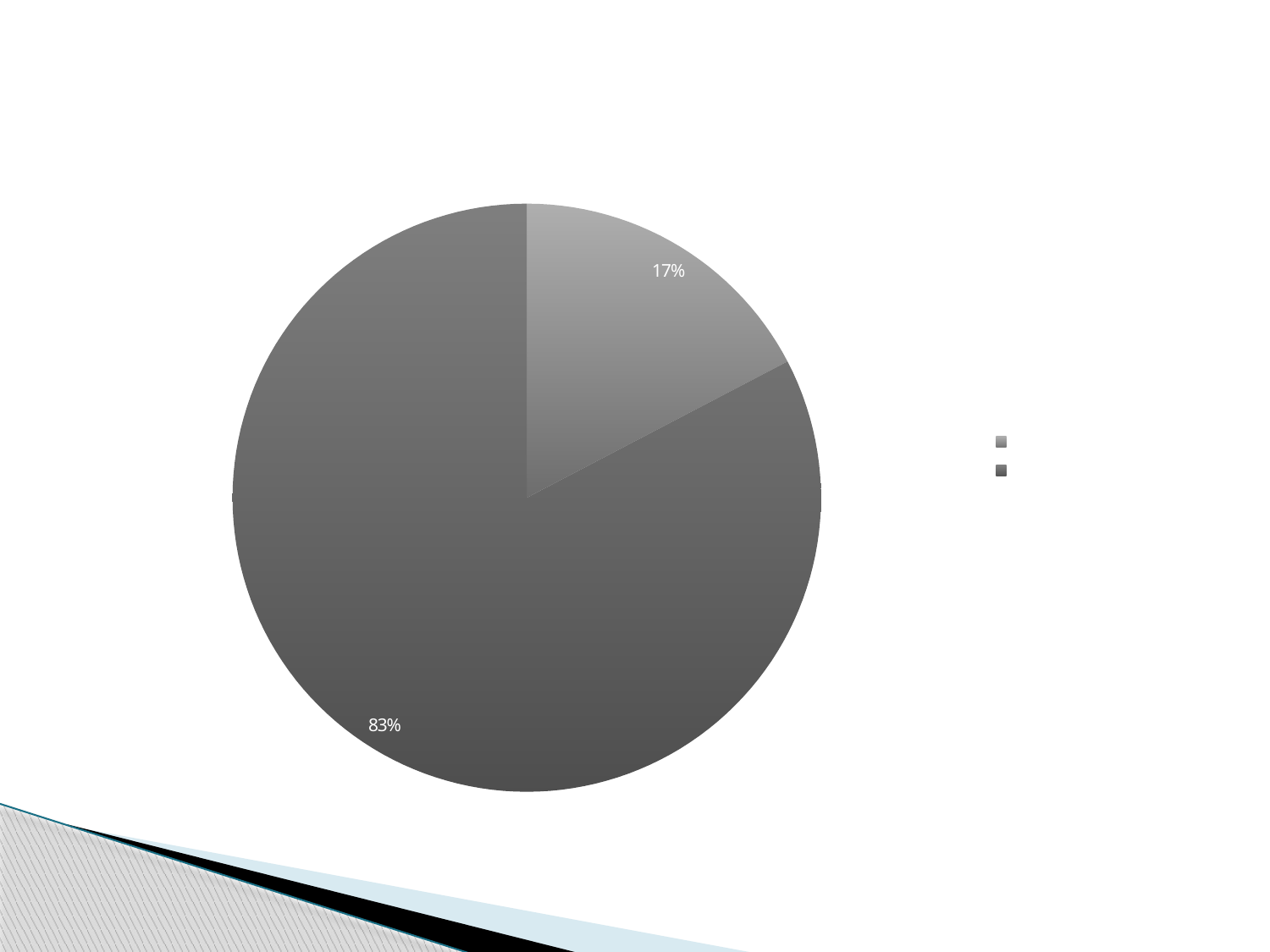
What percentage is shown on the larger, darker grey slice of the pie chart? 83% What is the smallest share shown in the pie chart? 17% Which slice is larger in the pie chart, the lighter grey one or the darker grey one? the darker grey one How many slices does the pie chart have? 2 What percentage is shown on the smaller, lighter grey slice of the pie chart? 17% By how many percentage points does the larger slice exceed the smaller slice in the pie chart? 66 What kind of chart is shown on the slide? pie chart How many entries does the legend of the pie chart list? 2 What share of the pie does the darker grey slice represent? 83% What is the largest share shown in the pie chart? 83% Is the share of the lighter grey slice greater or less than 50%? less Where is the legend positioned relative to the pie chart? to the right